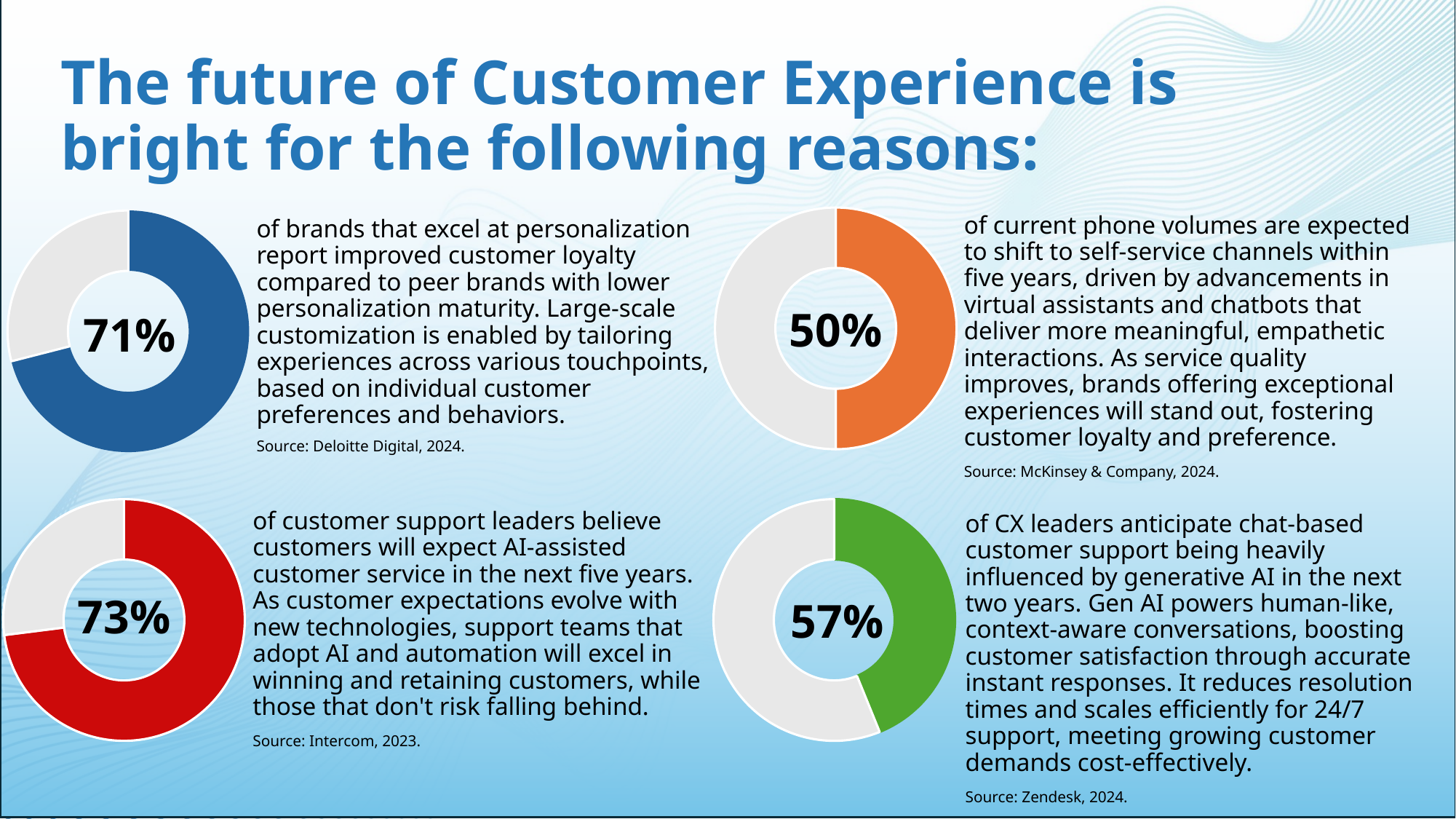
What is the difference between the percentage in the bottom-left donut chart and the percentage in the top-right donut chart? 23% What colour is the filled segment of the bottom-left donut chart? Red Which of the four donut charts shows the lowest percentage? The top-right chart (50%) Which of the four donut charts shows the highest percentage? The bottom-left chart (73%) Which is larger: the percentage in the top-left donut chart or the percentage in the bottom-right donut chart? The top-left chart (71%) What percentage is shown in the top-left donut chart? 71% What percentage is shown in the bottom-right donut chart? 57% What percentage is shown in the top-right donut chart? 50% How many donut charts are on the slide? 4 What percentage is shown in the bottom-left donut chart? 73% What source is cited for the top-right donut chart (50%)? McKinsey & Company, 2024 What kind of chart is used to display the percentages on the slide? Donut chart